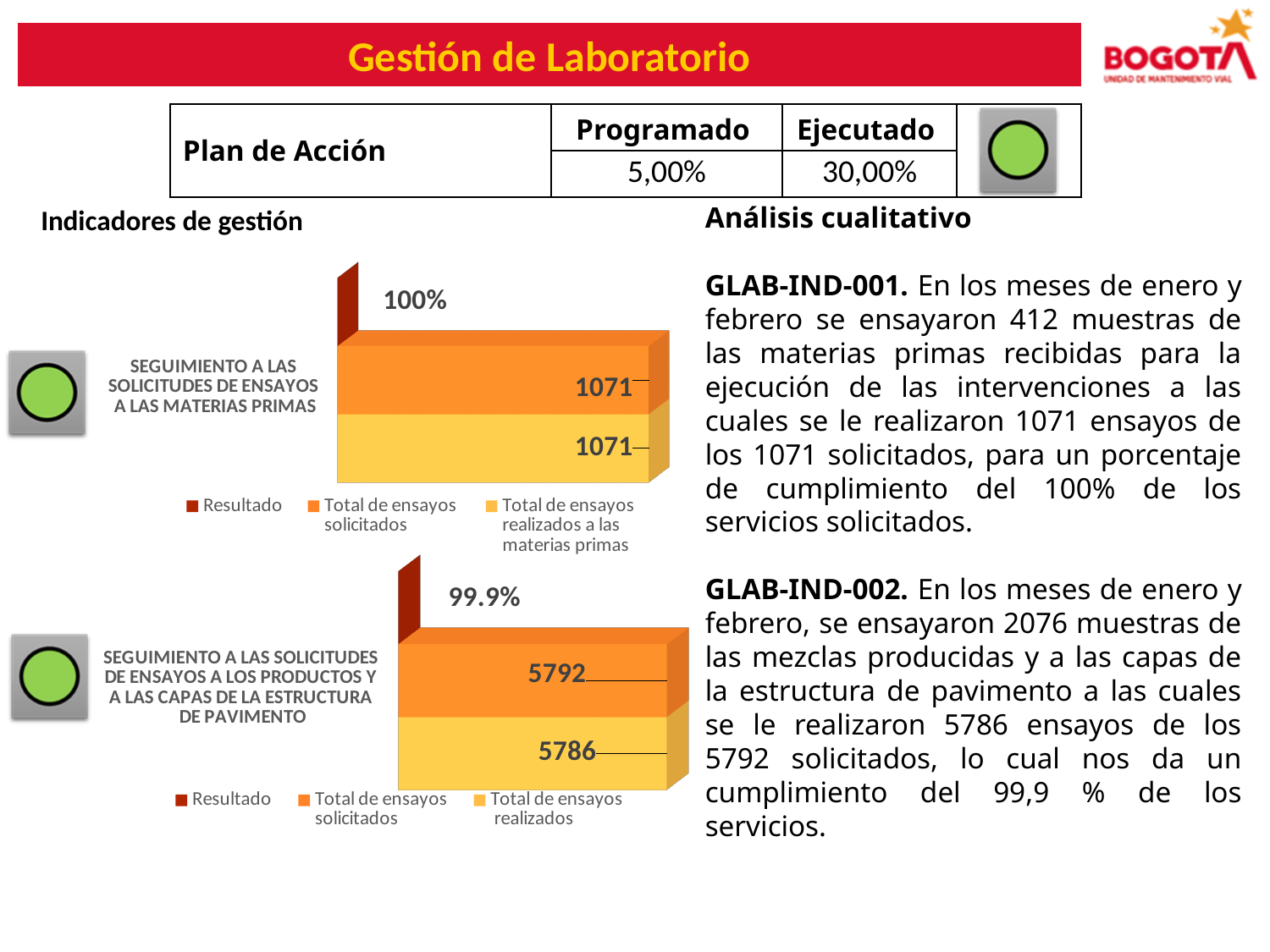
In the top chart (Seguimiento a las solicitudes de ensayos a las materias primas), what is the value for Total de ensayos solicitados? 1071 In the top chart (Seguimiento a las solicitudes de ensayos a las materias primas), what is the value labelled for Resultado? 100% In the bottom chart (Seguimiento a las solicitudes de ensayos a los productos y a las capas de la estructura de pavimento), what is the value for Total de ensayos realizados? 5786 How many series does the legend of the top chart (Seguimiento a las solicitudes de ensayos a las materias primas) list? 3 In the bottom chart (Seguimiento a las solicitudes de ensayos a los productos y a las capas de la estructura de pavimento), what is the difference between Total de ensayos solicitados and Total de ensayos realizados? 6 In the bottom chart (Seguimiento a las solicitudes de ensayos a los productos y a las capas de la estructura de pavimento), what is the value for Total de ensayos solicitados? 5792 In the bottom chart (Seguimiento a las solicitudes de ensayos a los productos y a las capas de la estructura de pavimento), which is larger: Total de ensayos solicitados or Total de ensayos realizados? Total de ensayos solicitados What kind of chart is the top chart (Seguimiento a las solicitudes de ensayos a las materias primas)? Bar chart How many series does the legend of the bottom chart (Seguimiento a las solicitudes de ensayos a los productos y a las capas de la estructura de pavimento) list? 3 In the top chart (Seguimiento a las solicitudes de ensayos a las materias primas), what colour is the Resultado series in the legend? Dark red In the bottom chart (Seguimiento a las solicitudes de ensayos a los productos y a las capas de la estructura de pavimento), what is the value labelled for Resultado? 99.9% In the top chart (Seguimiento a las solicitudes de ensayos a las materias primas), what is the value for Total de ensayos realizados a las materias primas? 1071